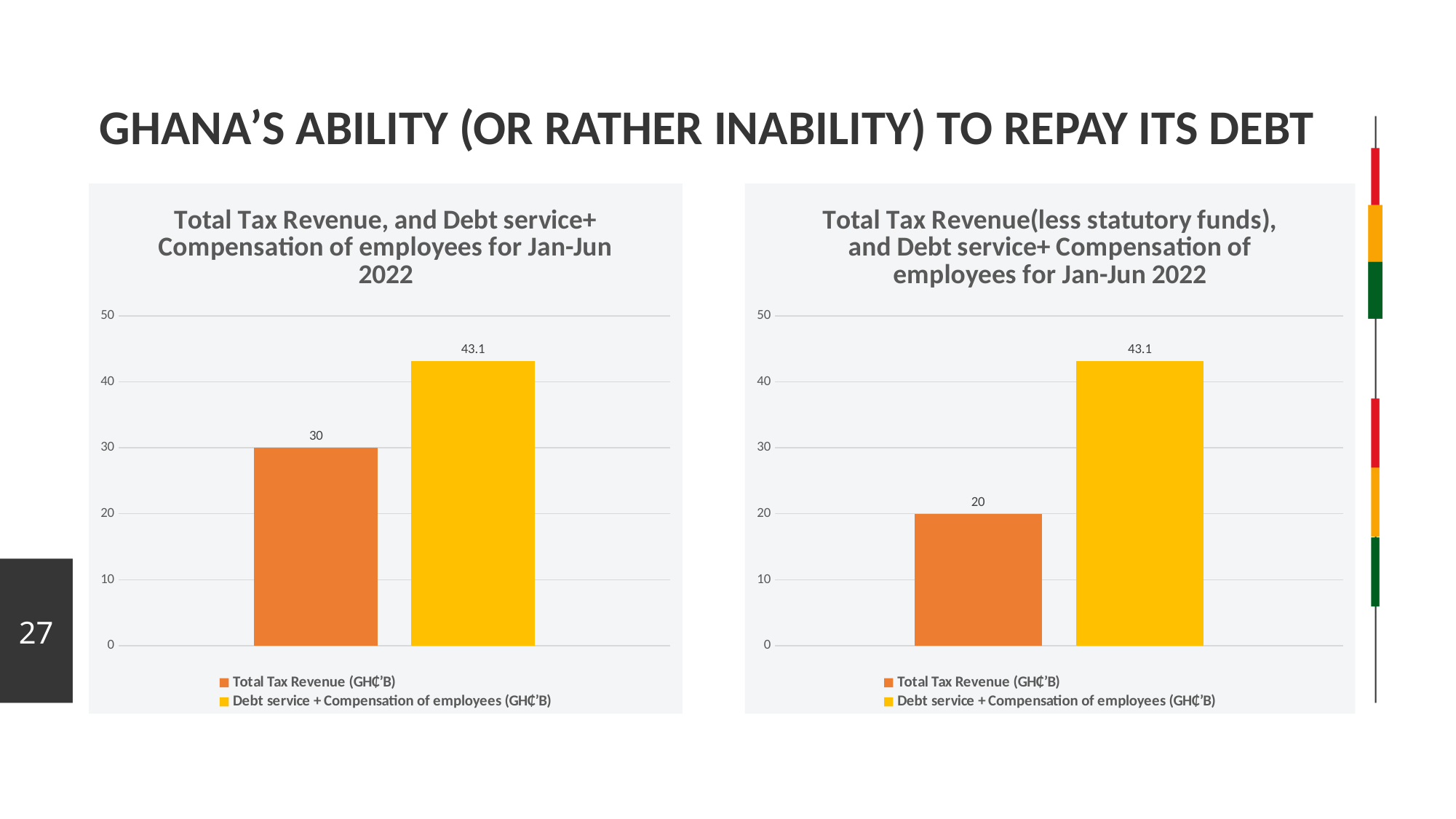
In the right chart, is Total Tax Revenue larger or smaller than Debt service + Compensation of employees? smaller In the right chart, which series has the lower value? Total Tax Revenue (GH₵'B) In the left chart, which series has the higher value? Debt service + Compensation of employees (GH₵'B) In the right chart, what is the difference between Debt service + Compensation of employees and Total Tax Revenue? 23.1 In the left chart, what is the value for Debt service + Compensation of employees (GH₵'B)? 43.1 How many series does the legend of the right chart list? 2 What type of chart is the left chart? bar chart In the right chart, what is the value for Debt service + Compensation of employees (GH₵'B)? 43.1 In the left chart, what is the value for Total Tax Revenue (GH₵'B)? 30 In the left chart, is the value for Debt service + Compensation of employees greater or less than 40? greater In the left chart, what is the difference between Debt service + Compensation of employees and Total Tax Revenue? 13.1 In the right chart, what is the value for Total Tax Revenue (GH₵'B)? 20